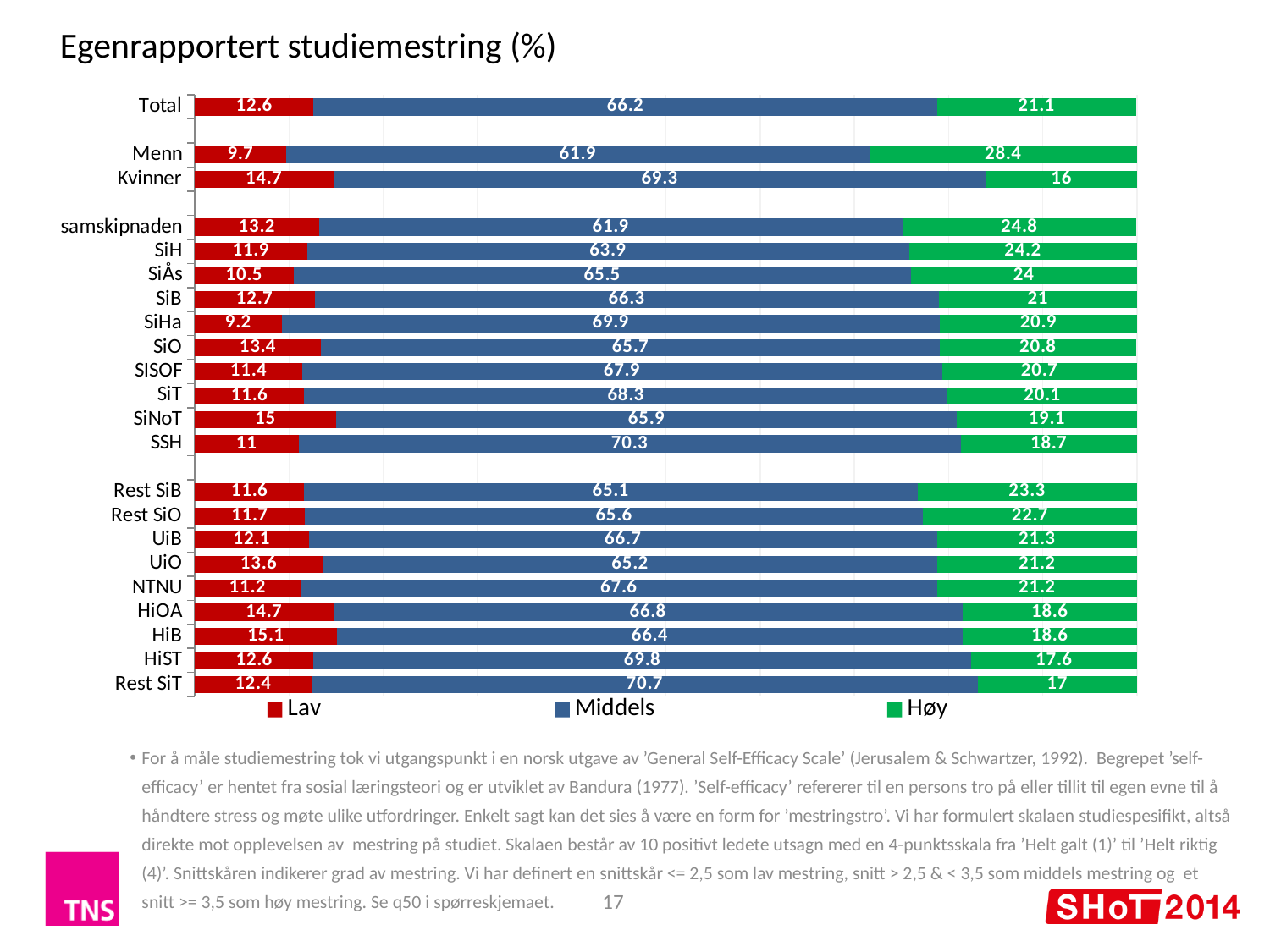
Which has the larger Høy value, samskipnaden or SiB? samskipnaden What kind of chart is shown on the slide? Stacked bar chart What is the difference between the Høy values for Menn and Kvinner? 12.4 What is the Middels value for SSH? 70.3 Which category has the highest Høy value? Menn What is the Høy value for Rest SiT? 17 What is the Lav value for Total? 12.6 What is the Høy value for Menn? 28.4 How many series does the legend list? 3 Which category has the lowest Lav value? SiHa What is the total of the stacked bar for Menn? 100 How many categories are shown on the chart? 22